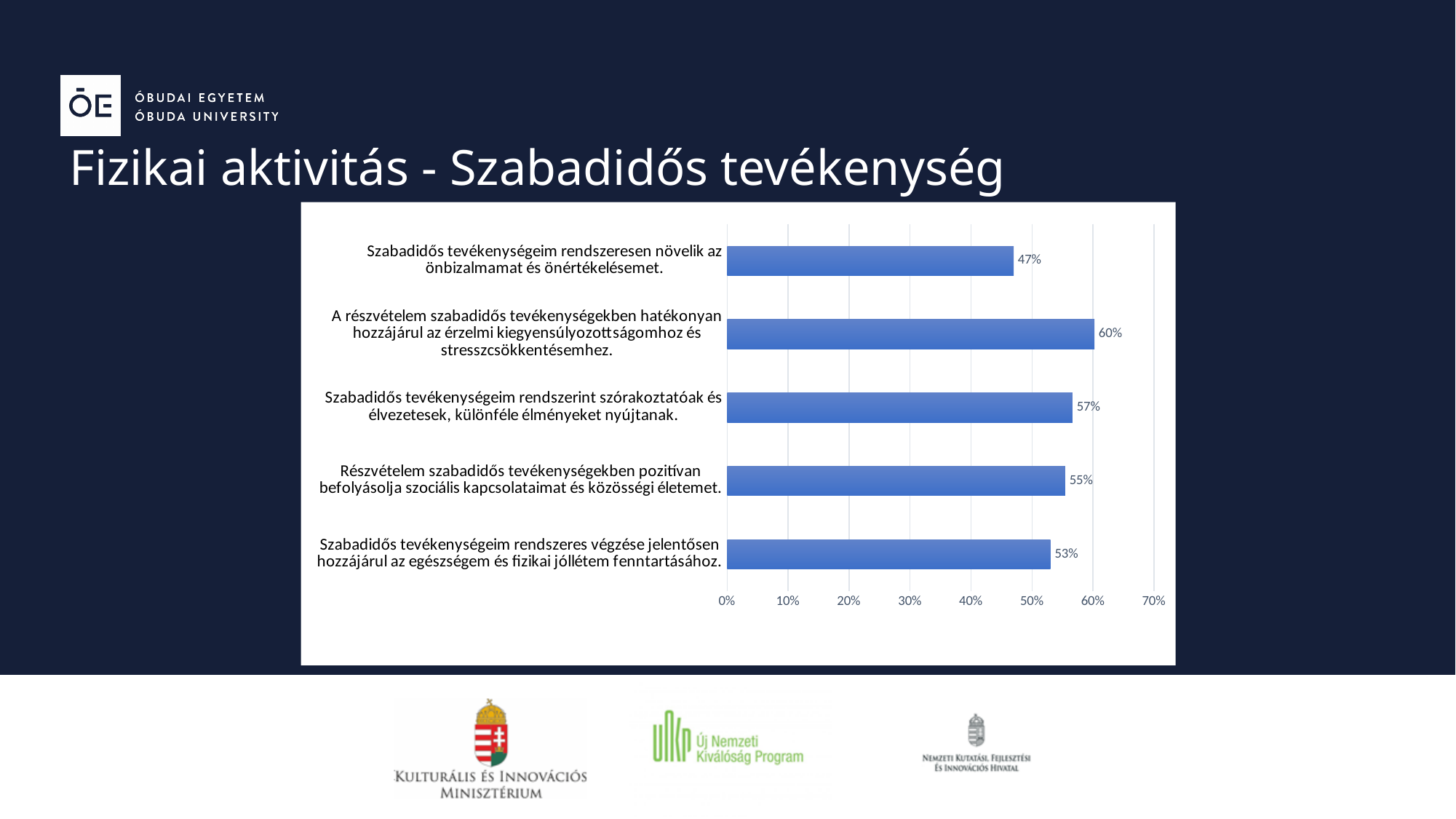
What is the value for "Részvételem szabadidős tevékenységekben pozitívan befolyásolja szociális kapcsolataimat és közösségi életemet."? 55% What is the value for "Szabadidős tevékenységeim rendszeres végzése jelentősen hozzájárul az egészségem és fizikai jóllétem fenntartásához."? 53% Is the value for "Szabadidős tevékenységeim rendszeresen növelik az önbizalmamat és önértékelésemet." greater or less than 50%? less Which category has the lowest value? Szabadidős tevékenységeim rendszeresen növelik az önbizalmamat és önértékelésemet. Which is larger: the value for "Szabadidős tevékenységeim rendszerint szórakoztatóak és élvezetesek, különféle élményeket nyújtanak." or the value for "Szabadidős tevékenységeim rendszeres végzése jelentősen hozzájárul az egészségem és fizikai jóllétem fenntartásához."? Szabadidős tevékenységeim rendszerint szórakoztatóak és élvezetesek, különféle élményeket nyújtanak. How many categories are shown in the chart? 5 What is the difference between the highest value (60%) and the lowest value (47%)? 13% What is the value for "A részvételem szabadidős tevékenységekben hatékonyan hozzájárul az érzelmi kiegyensúlyozottságomhoz és stresszcsökkentésemhez."? 60% What is the value for "Szabadidős tevékenységeim rendszerint szórakoztatóak és élvezetesek, különféle élményeket nyújtanak."? 57% Which category has the highest value? A részvételem szabadidős tevékenységekben hatékonyan hozzájárul az érzelmi kiegyensúlyozottságomhoz és stresszcsökkentésemhez. What is the value for "Szabadidős tevékenységeim rendszeresen növelik az önbizalmamat és önértékelésemet."? 47% What kind of chart is shown on the slide? bar chart